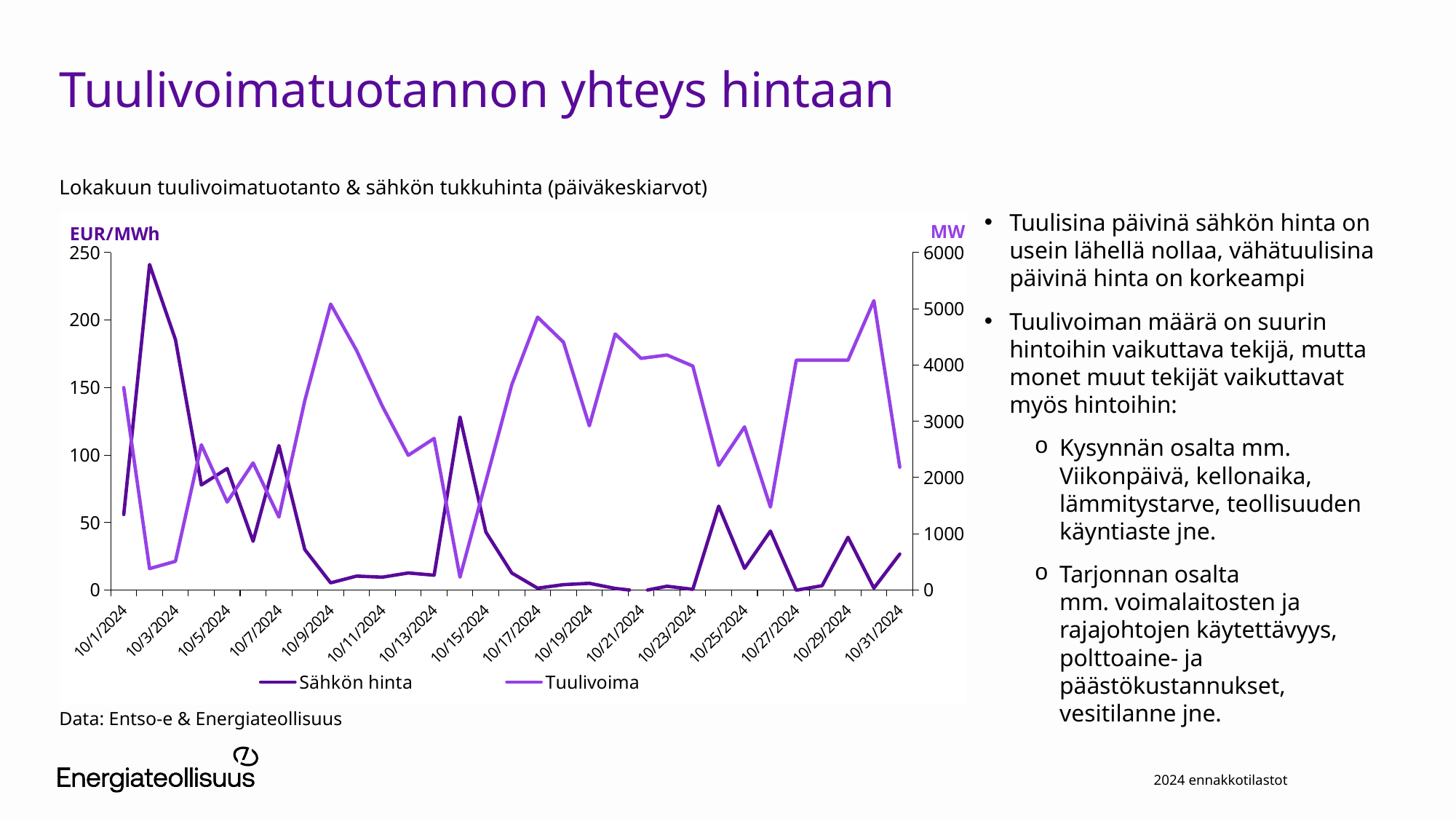
Does Sähkön hinta rise or fall between 10/2/2024 and 10/9/2024? fall How many series does the chart legend list? 2 What unit is shown on the left vertical axis of the chart? EUR/MWh Does Tuulivoima rise or fall between 10/26/2024 and 10/30/2024? rise Which two series are listed in the chart legend? Sähkön hinta and Tuulivoima Is the value of Tuulivoima on 10/26/2024 greater or less than 2000? less Is the value of Sähkön hinta on 10/9/2024 greater or less than 50? less Is the value of Tuulivoima on 10/9/2024 greater or less than 4000? greater What kind of chart is shown on the slide? line chart On which date does Sähkön hinta reach its highest value? 10/2/2024